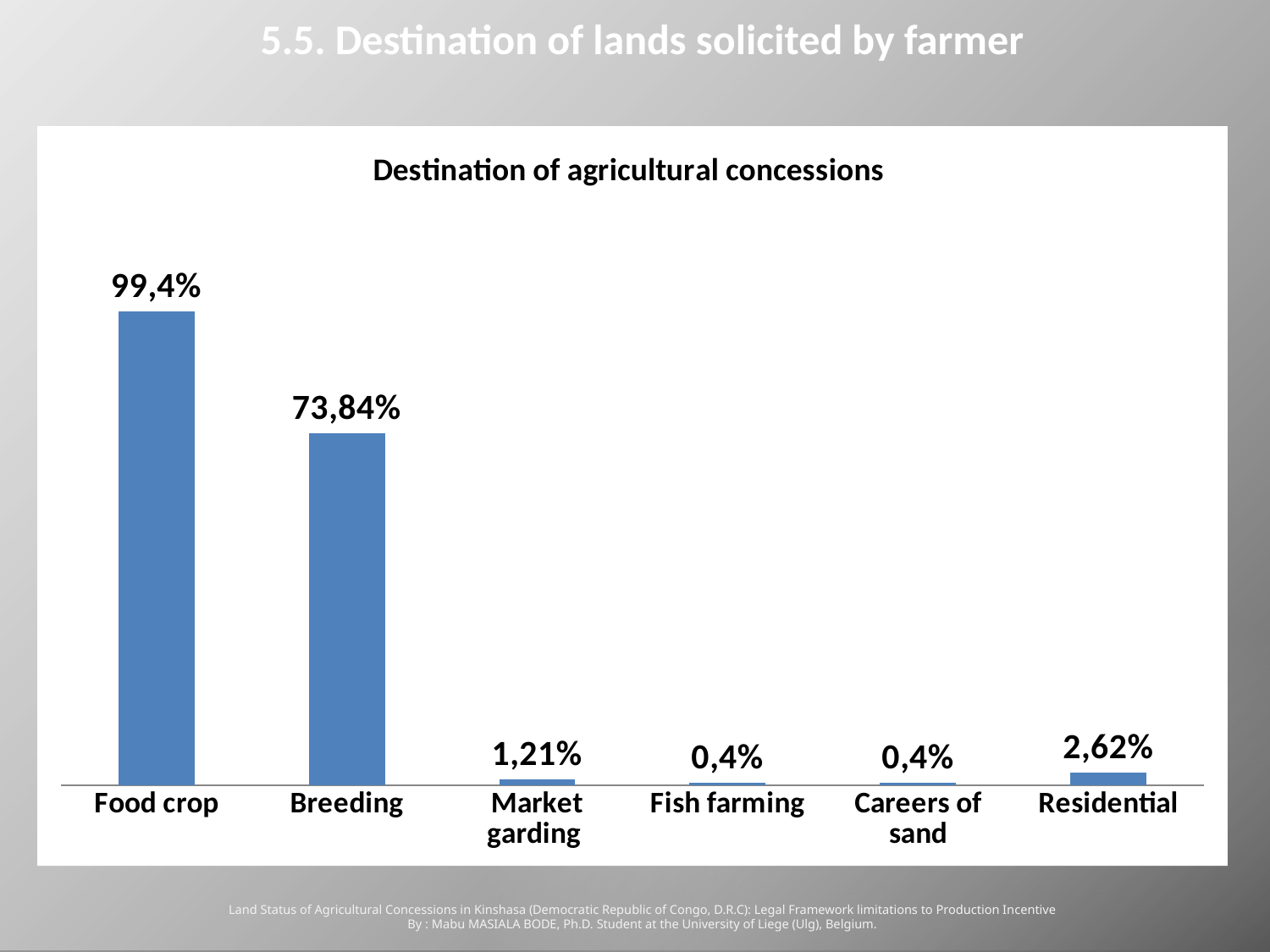
How many categories are shown on the x axis? 6 What is the title of the chart? Destination of agricultural concessions What is the value for Market garding? 1,21% What is the value for Breeding? 73,84% What is the value for Food crop? 99,4% What is the difference between the values for Food crop and Breeding? 25,56% What is the value for Fish farming? 0,4% What kind of chart is shown? Bar chart What is the difference between the values for Residential and Market garding? 1,41% Which category has the highest value? Food crop What is the value for Residential? 2,62% Which is larger, the value for Breeding or the value for Residential? Breeding